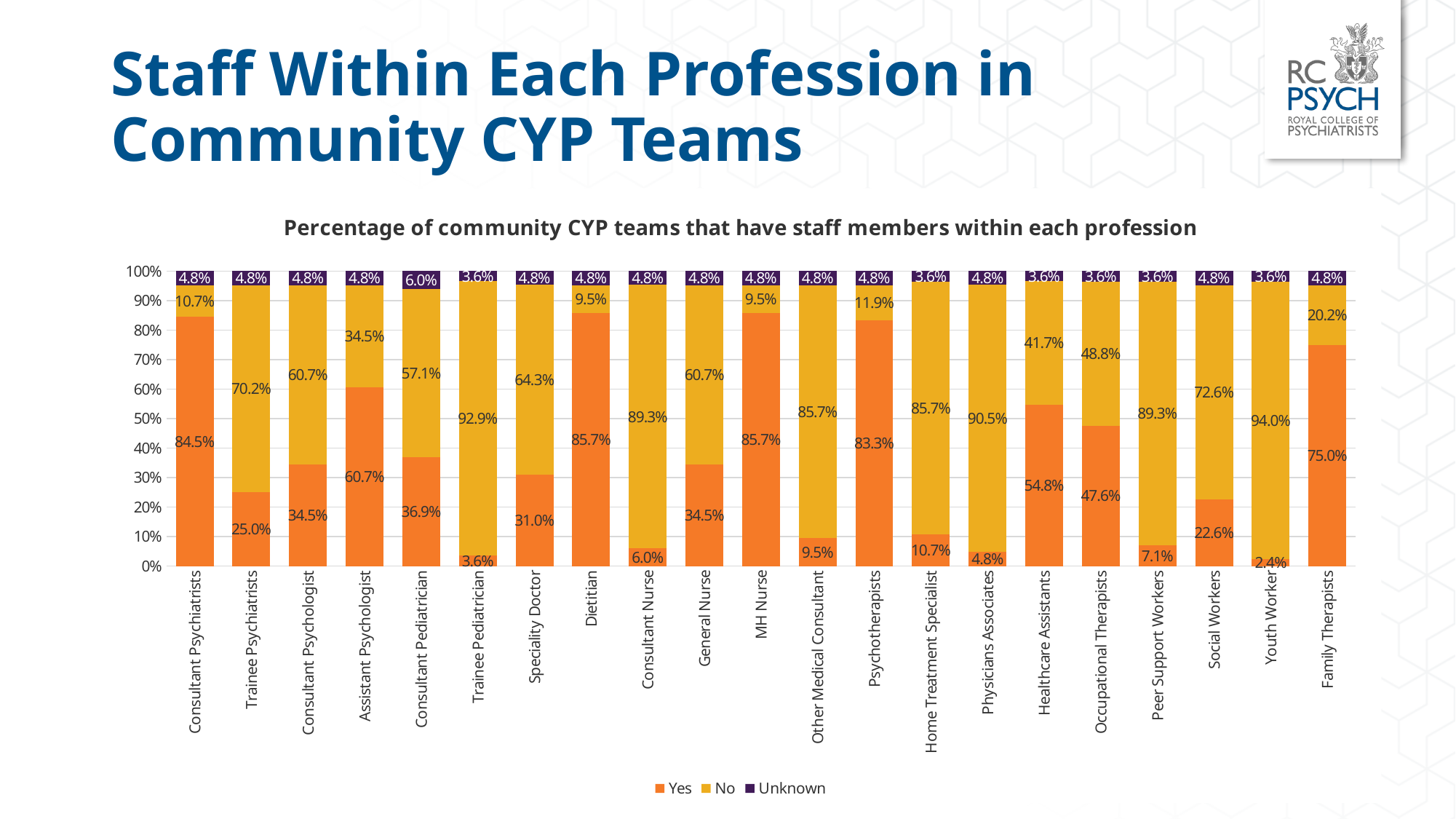
What is the total of the stacked bar for Psychotherapists? 100% What is the "No" value for Trainee Psychiatrists? 70.2% Which has a larger "Yes" value, Assistant Psychologist or Consultant Psychologist? Assistant Psychologist What percentage of community CYP teams answered "Yes" for Consultant Psychiatrists? 84.5% What kind of chart is shown? Stacked bar chart Which profession has the lowest "Yes" value? Youth Worker Which profession has the highest "No" value? Youth Worker What is the difference between the "Yes" values for Healthcare Assistants and Occupational Therapists? 7.2% How many professions are shown on the x axis? 21 What is the "Unknown" value for Consultant Pediatrician? 6.0% What is the "Yes" value for Family Therapists? 75.0% How many series does the legend list? 3